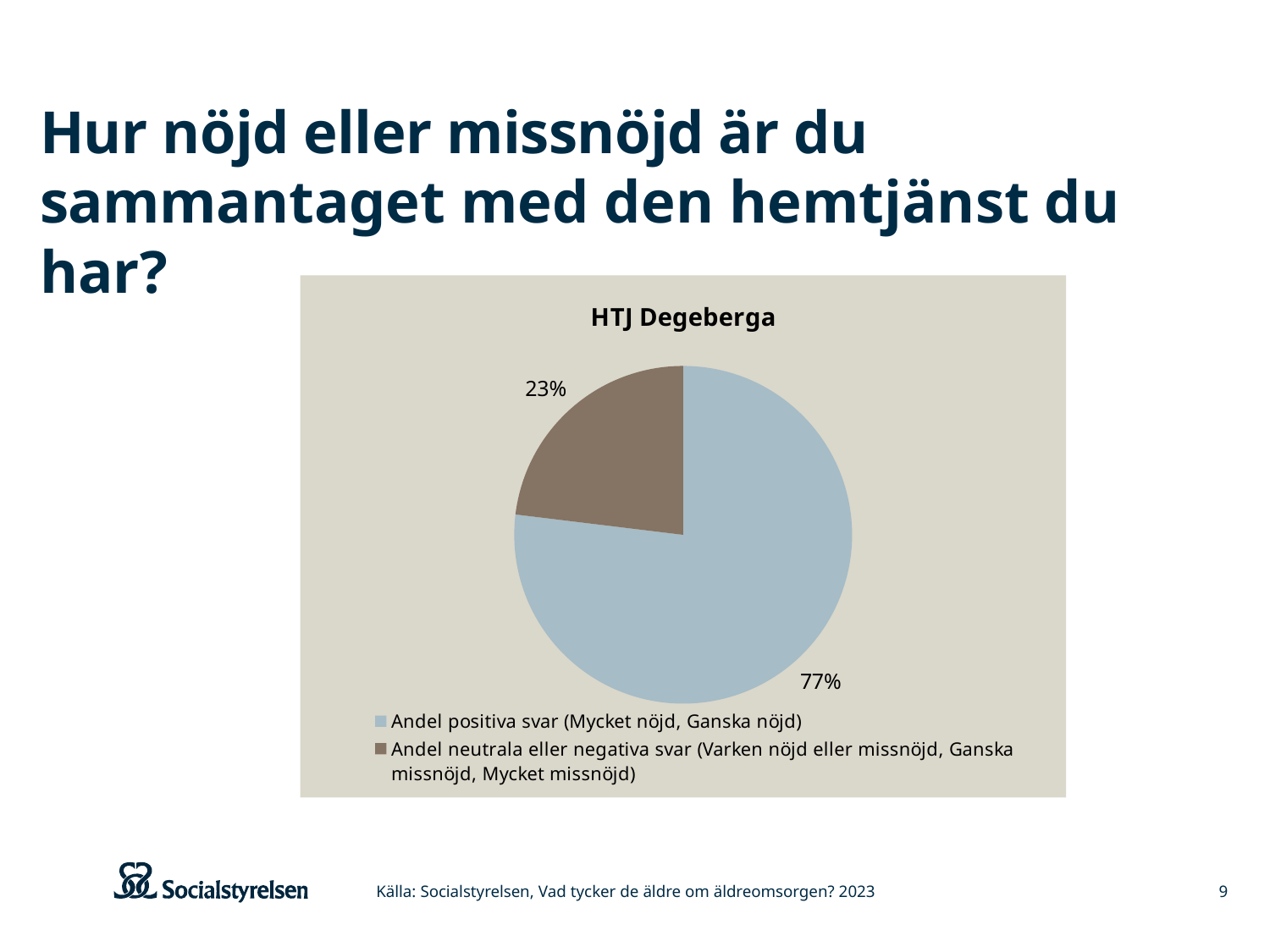
What kind of chart is shown on the slide? pie chart How many slices does the pie chart have? 2 How many entries does the legend list? 2 What share of the pie is 'Andel neutrala eller negativa svar (Varken nöjd eller missnöjd, Ganska missnöjd, Mycket missnöjd)'? 23% What share of the pie is 'Andel positiva svar (Mycket nöjd, Ganska nöjd)'? 77% Which slice is the largest? Andel positiva svar (Mycket nöjd, Ganska nöjd) What colour is the slice for 'Andel positiva svar (Mycket nöjd, Ganska nöjd)'? light blue-grey What is the total of the two slices shown? 100% What is the difference in percentage points between the positive slice and the neutral or negative slice? 54 percentage points Which slice is the smallest? Andel neutrala eller negativa svar (Varken nöjd eller missnöjd, Ganska missnöjd, Mycket missnöjd) What is the chart's title? HTJ Degeberga Which is larger: the share of positive answers or the share of neutral or negative answers? positive answers